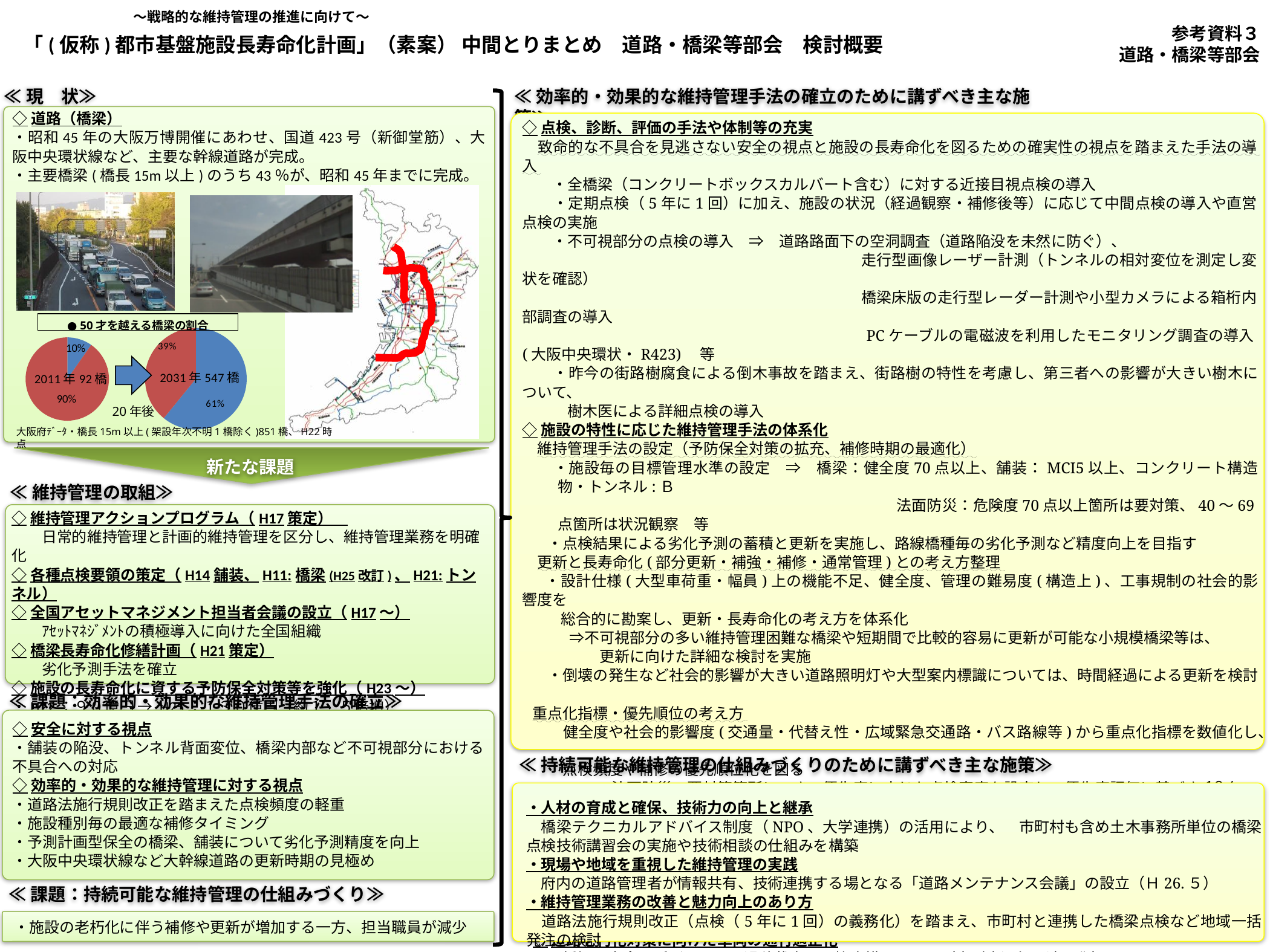
In the left pie chart (2011年 92橋), what percentage is shown for the blue slice? 10% Which pie chart has the larger blue slice, the 2011年 pie or the 2031年 pie? 2031年 What text appears below the arrow between the two pie charts? 20年後 In the right pie chart (2031年 547橋), which colour slice is the largest? blue In the right pie chart (2031年 547橋), what is the difference in percentage points between the blue slice and the red slice? 22 percentage points How many pie charts are shown under "50才を越える橋梁の割合"? 2 In the right pie chart (2031年 547橋), what percentage is shown for the red slice? 39% What kind of chart is used under the heading "50才を越える橋梁の割合"? pie chart In the left pie chart (2011年 92橋), what is the difference in percentage points between the red slice and the blue slice? 80 percentage points What label is written in the centre of the left pie chart? 2011年 92橋 In the left pie chart (2011年 92橋), what percentage is shown for the red slice? 90% In the right pie chart (2031年 547橋), what percentage is shown for the blue slice? 61%